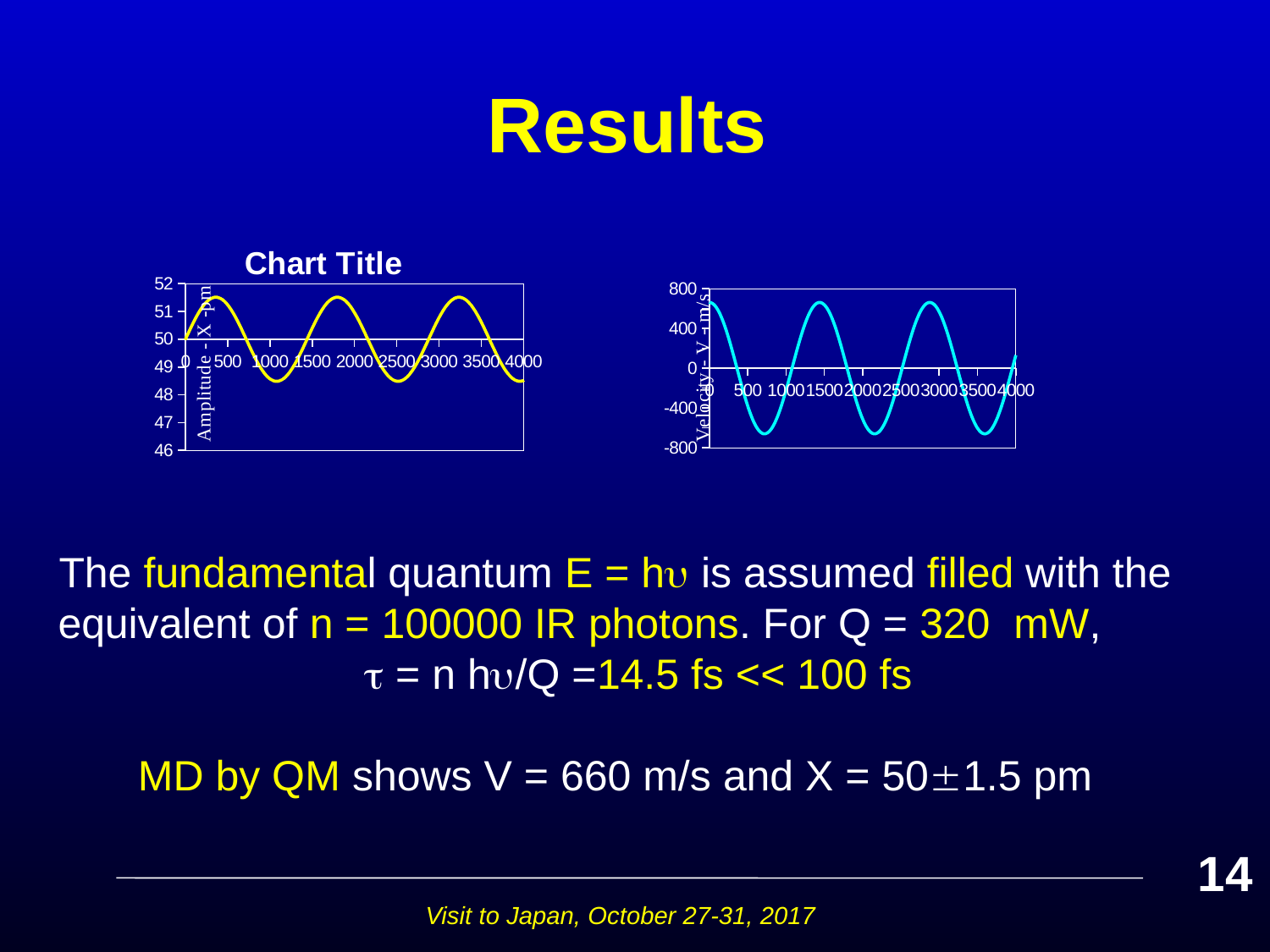
In the left chart titled "Chart Title", is the highest value of the curve greater or less than 51? greater In the right chart (Velocity - V - m/s), is the lowest value of the curve greater or less than -400? less In the right chart (Velocity - V - m/s), is the peak value of the curve greater or less than 800? less Does the curve in the left chart titled "Chart Title" rise steadily, fall steadily, or oscillate along the x axis? oscillate What kind of chart is the left chart titled "Chart Title"? line chart What kind of chart is the right chart (with the Velocity axis)? line chart What is the y-axis label of the right chart? Velocity - V - m/s What is the title of the left chart? Chart Title